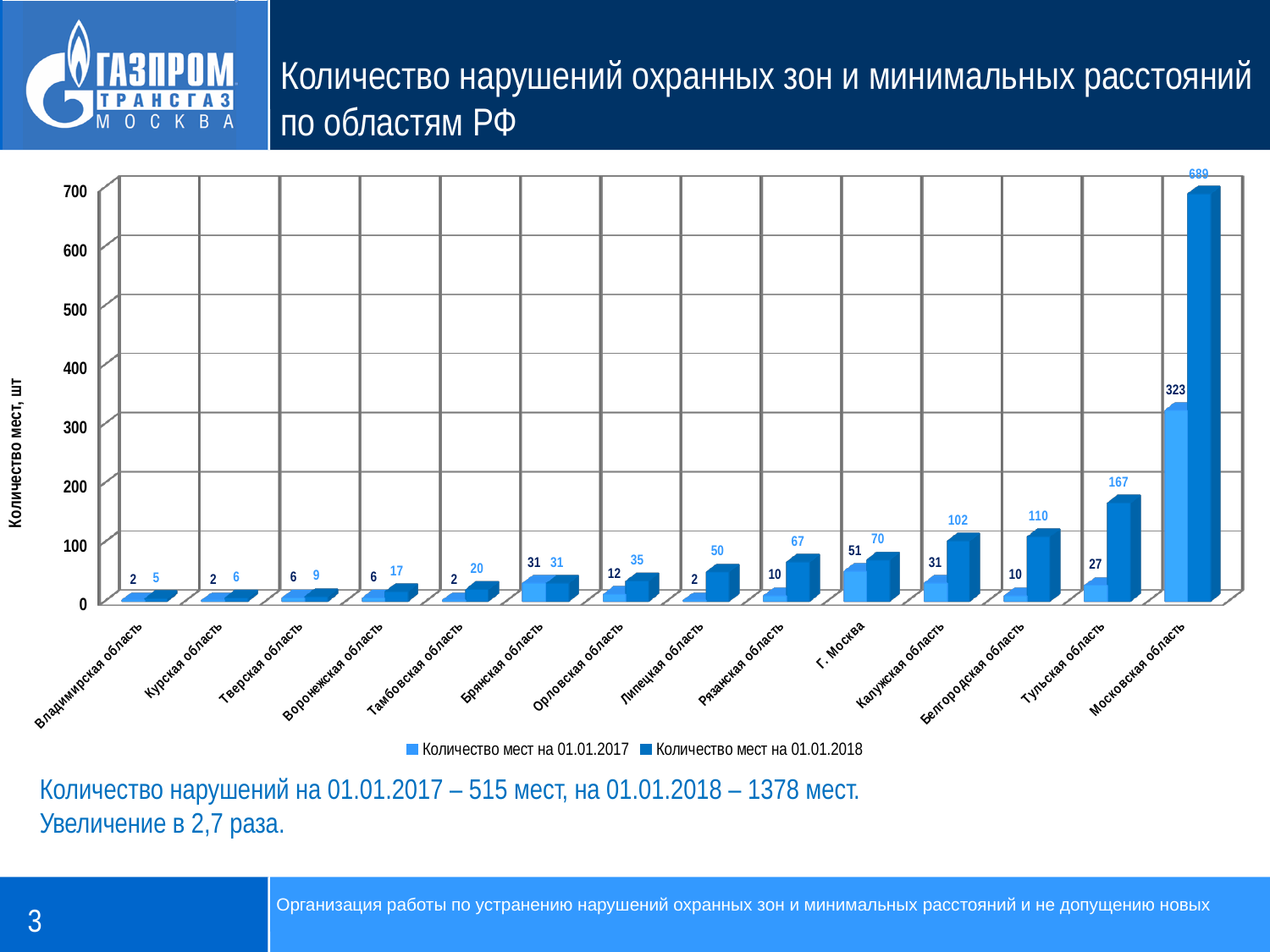
Which category has the highest value in the series 'Количество мест на 01.01.2018'? Московская область What is the label of the vertical axis? Количество мест, шт How many regions (categories) are shown on the x axis? 14 What is the value for Калужская область in the series 'Количество мест на 01.01.2018'? 102 What is the difference between the 01.01.2018 and 01.01.2017 values for Московская область? 366 What kind of chart is shown on the slide? Bar chart What is the value for Тульская область in the series 'Количество мест на 01.01.2017'? 27 What is the value for Московская область in the series 'Количество мест на 01.01.2018'? 689 Which is larger for г. Москва: the value on 01.01.2017 or on 01.01.2018? 01.01.2018 Is the value for Тульская область on 01.01.2018 greater or less than 100? greater What is the difference between the 01.01.2018 and 01.01.2017 values for Белгородская область? 100 How many series does the legend list? 2